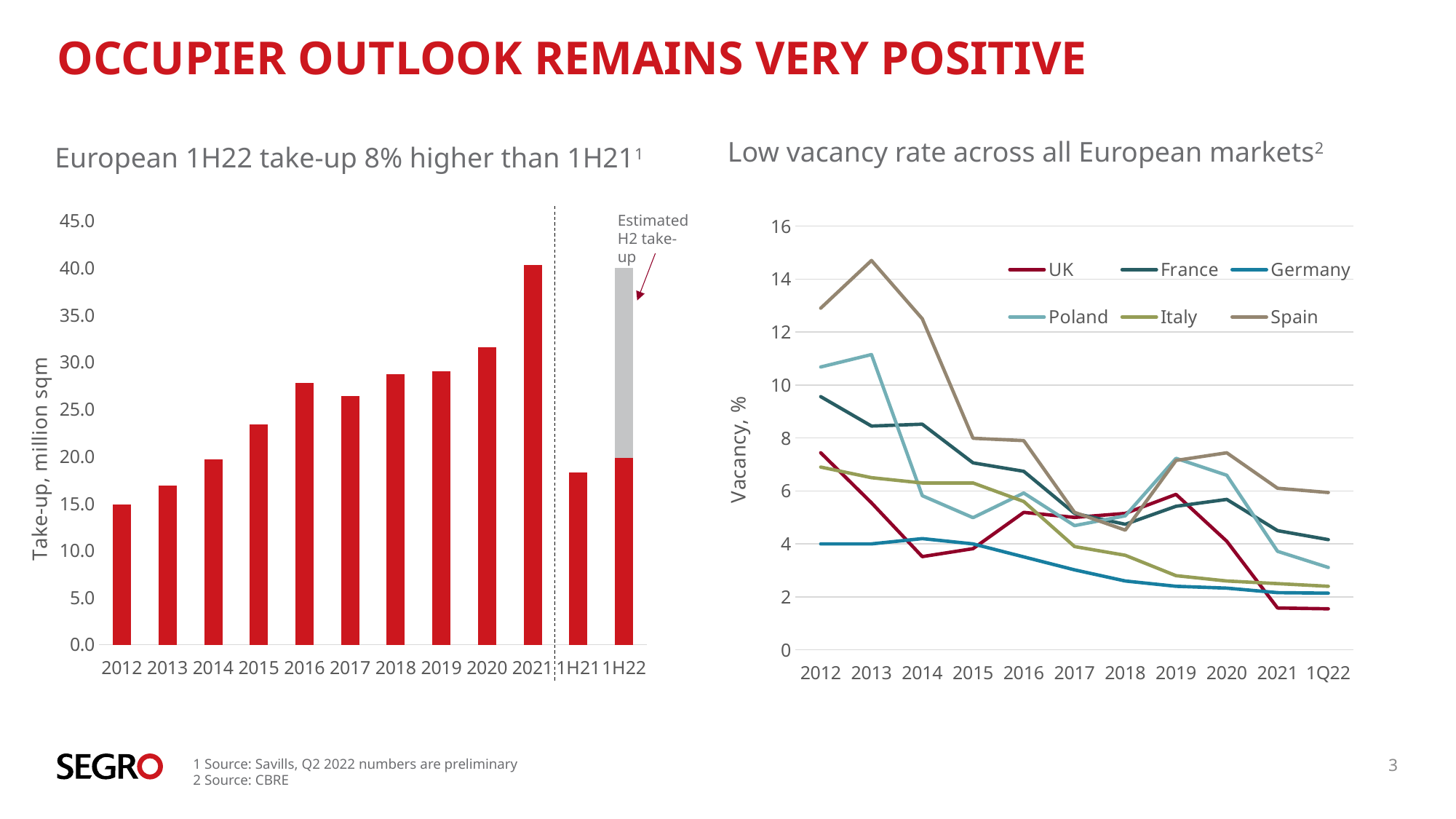
In the right vacancy chart, does the Spain line generally rise or fall from 2012 to 1Q22? fall What type of chart is the left chart titled 'European 1H22 take-up 8% higher than 1H21'? bar chart In the left take-up chart, which category has the lowest bar? 2012 In the right vacancy chart, how many series does the legend list? 6 In the left take-up chart, is the value for 2021 greater or less than 35.0? greater In the left take-up chart, how many categories are shown on the x axis? 12 What type of chart is the right chart titled 'Low vacancy rate across all European markets'? line chart In the right vacancy chart, is the value for Spain in 2012 greater or less than 12? greater In the left take-up chart, is the value for 1H21 greater or less than 20.0? less In the left take-up chart, which is larger, the bar for 2020 or the bar for 2017? 2020 In the left take-up chart, which category has the highest bar? 2021 In the right vacancy chart, which country has the highest vacancy rate in 2013? Spain